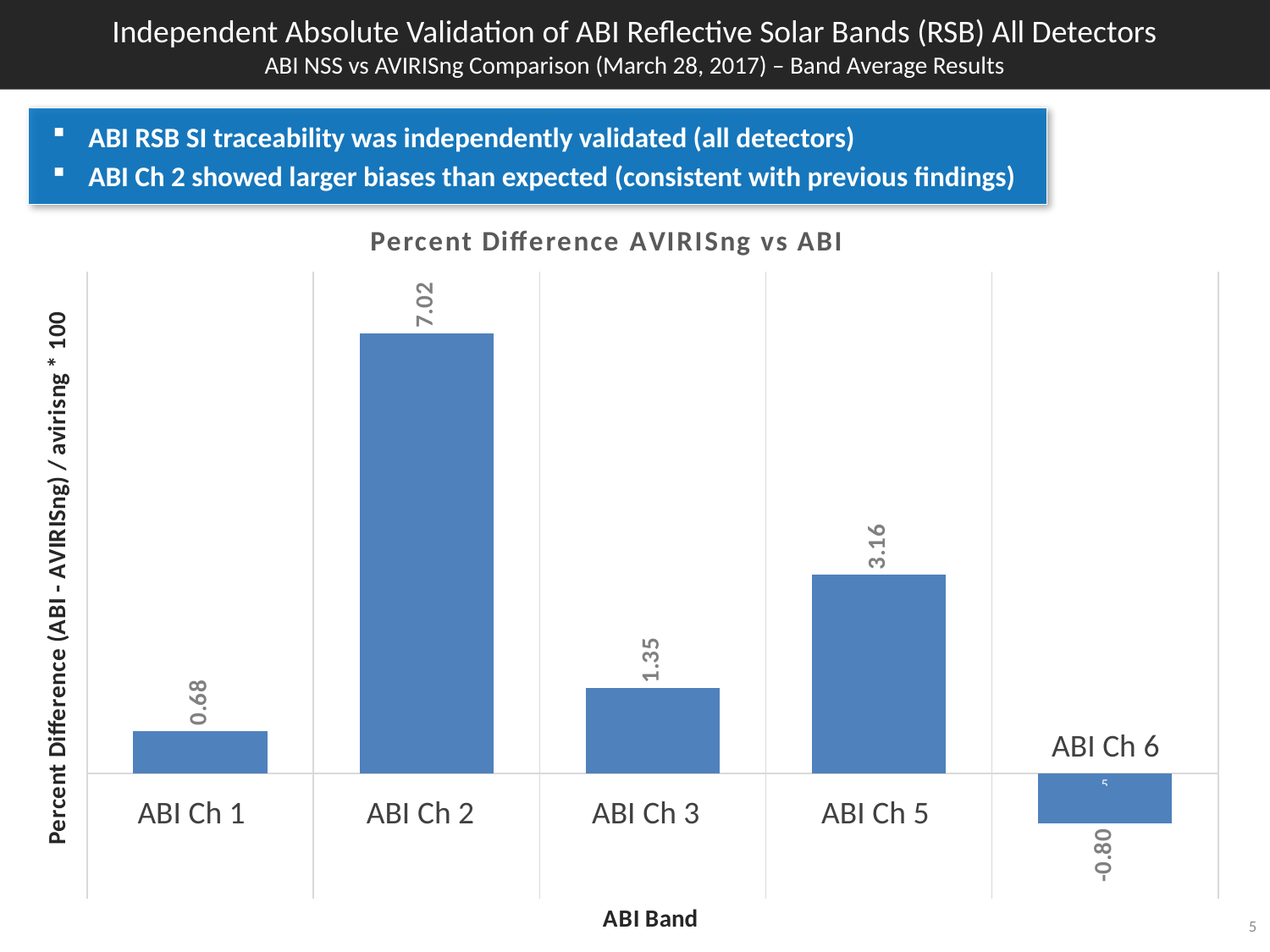
What is the x-axis label of the chart? ABI Band Which ABI band has the highest percent difference? ABI Ch 2 What is the value for ABI Ch 2 in the Percent Difference AVIRISng vs ABI chart? 7.02 What is the value for ABI Ch 1? 0.68 What is the value for ABI Ch 6? -0.80 Which ABI band has the lowest percent difference? ABI Ch 6 How many ABI bands are shown in the chart? 5 What is the difference between the values for ABI Ch 2 and ABI Ch 5? 3.86 What kind of chart is shown on the slide? Bar chart What is the title of the chart? Percent Difference AVIRISng vs ABI Which is larger, the value for ABI Ch 3 or the value for ABI Ch 1? ABI Ch 3 What is the value for ABI Ch 5? 3.16